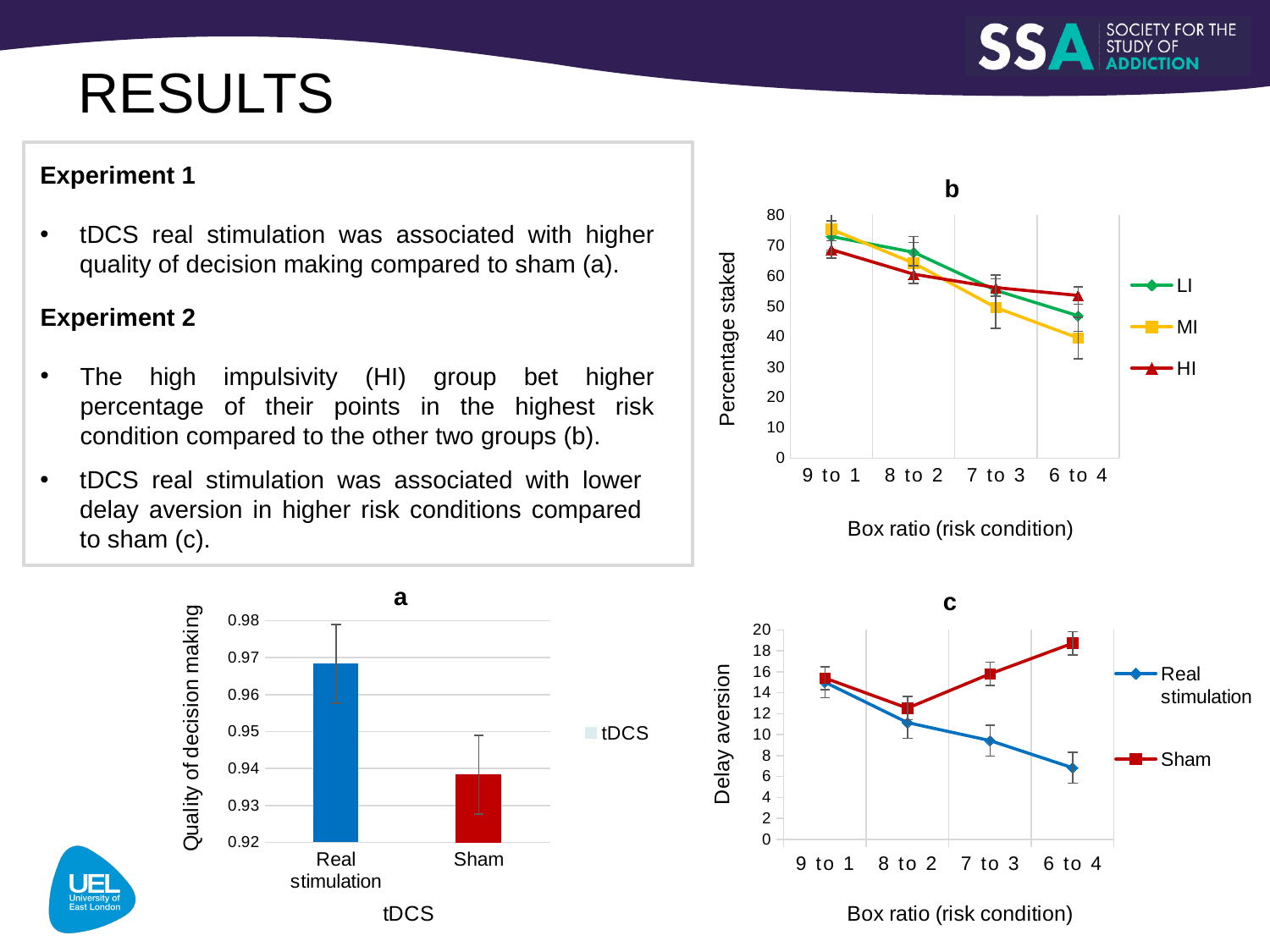
In chart b, is the percentage staked by MI at 6 to 4 greater or less than 50? less In chart a, is the value for Real stimulation greater or less than 0.96? greater In chart b, which group has the highest percentage staked at the 6 to 4 box ratio? HI What kind of chart is chart a? bar chart In chart c, which condition has the higher delay aversion at the 6 to 4 box ratio? Sham How many series does the legend of chart b list? 3 In chart c, is the delay aversion for Real stimulation at 6 to 4 greater or less than 8? less In chart b, does the percentage staked by MI rise or fall as the box ratio moves from 9 to 1 to 6 to 4? fall In chart a, which tDCS condition has the higher quality of decision making? Real stimulation How many box ratio conditions are plotted on the x axis of chart c? 4 In chart b, which group has the lowest percentage staked at the 6 to 4 box ratio? MI